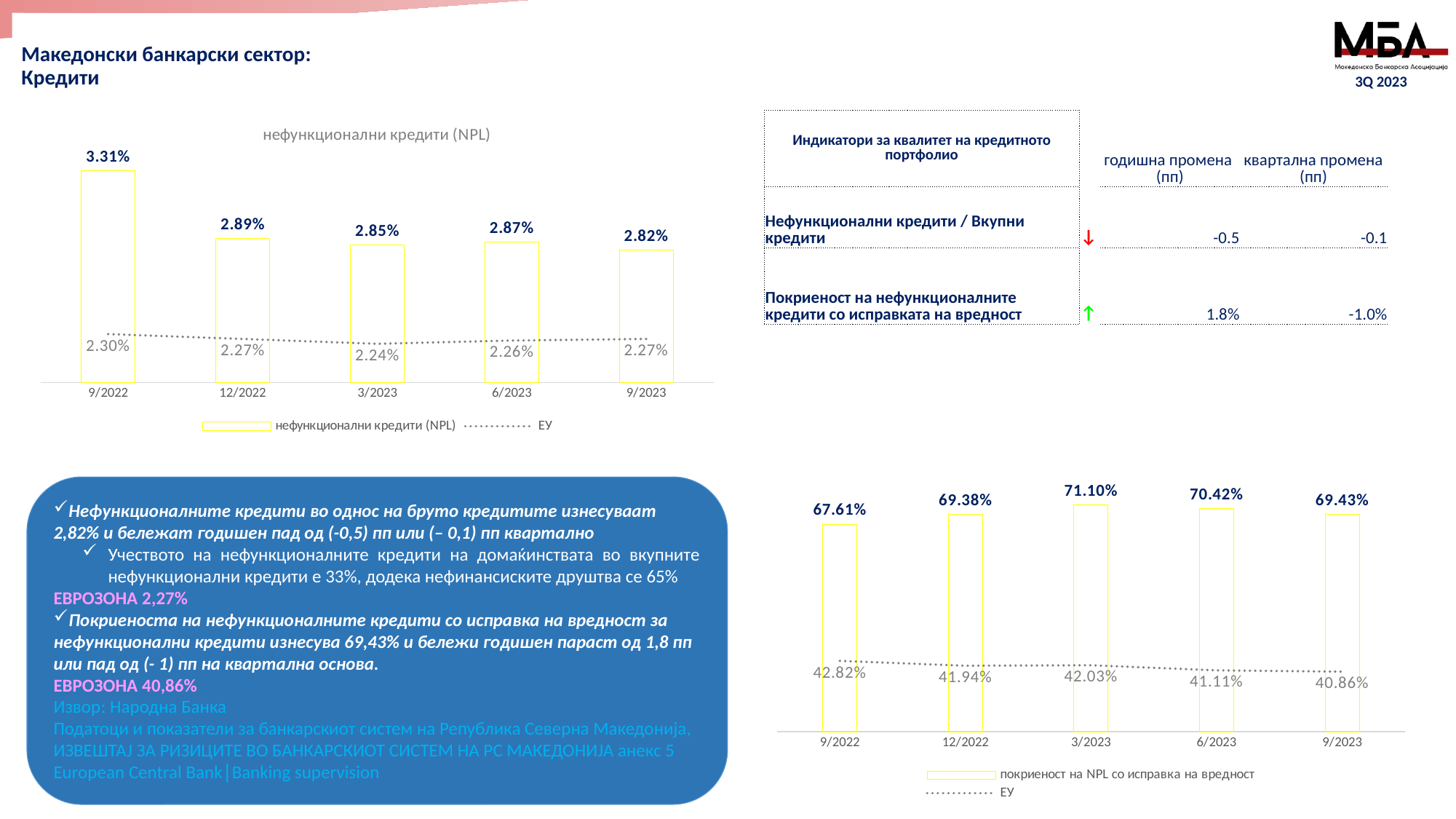
In the top-left chart titled 'нефункционални кредити (NPL)', which period has the lowest NPL bar? 9/2023 In the top-left chart titled 'нефункционални кредити (NPL)', which period has the highest NPL bar? 9/2022 In the bottom-right chart, what is the value of 'покриеност на NPL со исправка на вредност' for 3/2023? 71.10% In the bottom-right chart, what is the ЕУ value for 9/2023? 40.86% In the top-left chart titled 'нефункционални кредити (NPL)', what is the ЕУ value for 3/2023? 2.24% In the top-left chart titled 'нефункционални кредити (NPL)', what is the NPL value for 9/2022? 3.31% In the bottom-right chart, which period has the highest 'покриеност на NPL со исправка на вредност' bar? 3/2023 In the bottom-right chart, which is larger: the ЕУ value for 9/2022 or the ЕУ value for 9/2023? 9/2022 What kind of chart is the bottom-right chart? Bar chart with a line In the top-left chart titled 'нефункционални кредити (NPL)', how many periods are shown on the x axis? 5 In the top-left chart titled 'нефункционални кредити (NPL)', how many series does the legend list? 2 In the top-left chart titled 'нефункционални кредити (NPL)', what is the difference between the NPL value for 9/2022 and the NPL value for 9/2023? 0.49 percentage points